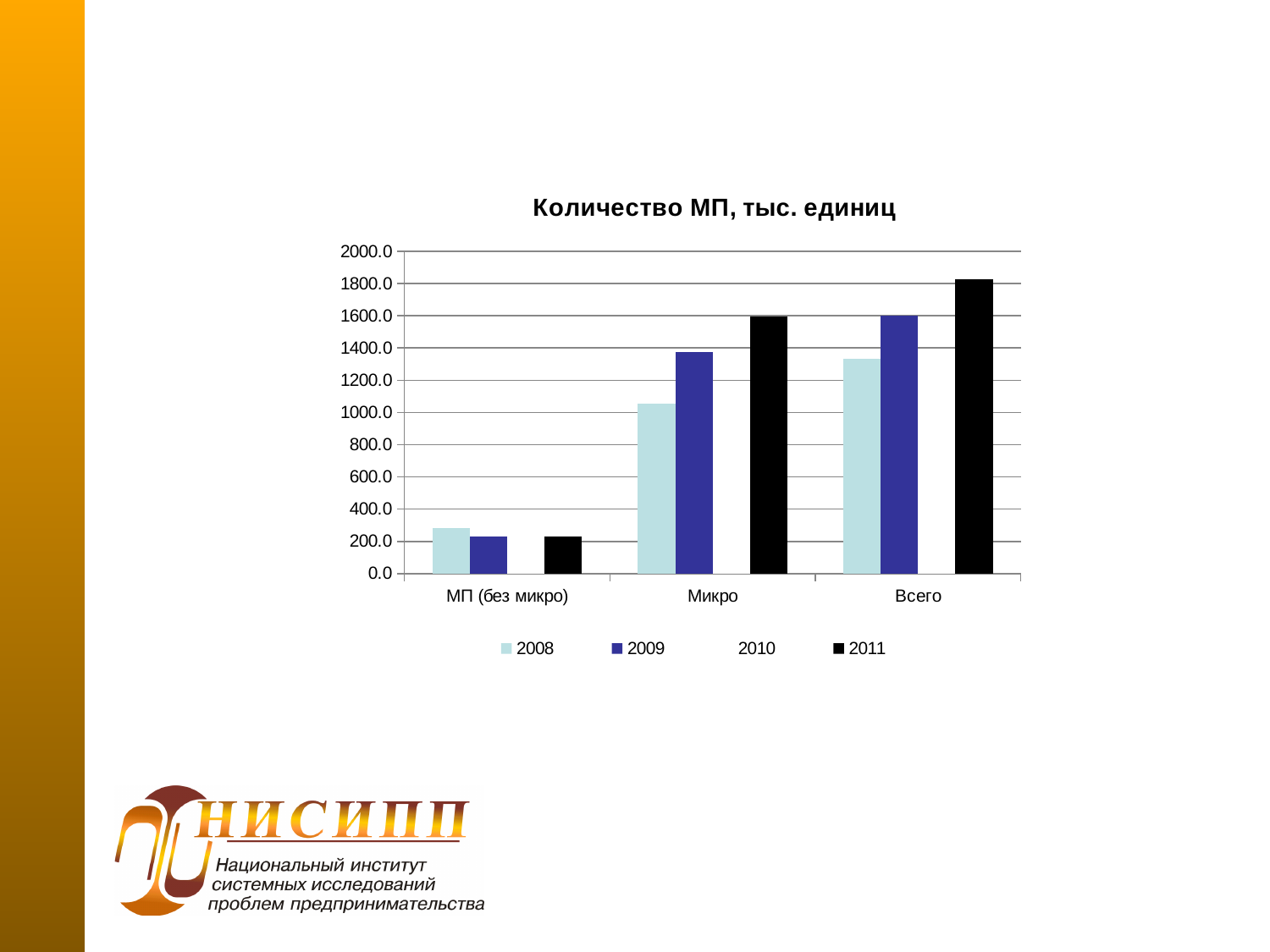
What is the title of the chart? Количество МП, тыс. единиц Which category has the lowest values in the chart? МП (без микро) What kind of chart is shown on the slide? bar chart Which is larger for Микро: the 2008 value or the 2009 value? 2009 Is the 2011 value for Микро greater or less than 1400.0? greater Do the 2011 values rise or fall moving from МП (без микро) to Всего along the x axis? rise Is the 2008 value for МП (без микро) greater or less than 400.0? less Which is larger for 2011: the value for Микро or the value for Всего? Всего Which category has the tallest bar in the chart? Всего Is the 2008 value for Микро greater or less than 1000.0? greater How many series does the chart legend list? 4 How many categories are shown on the x axis of the chart? 3